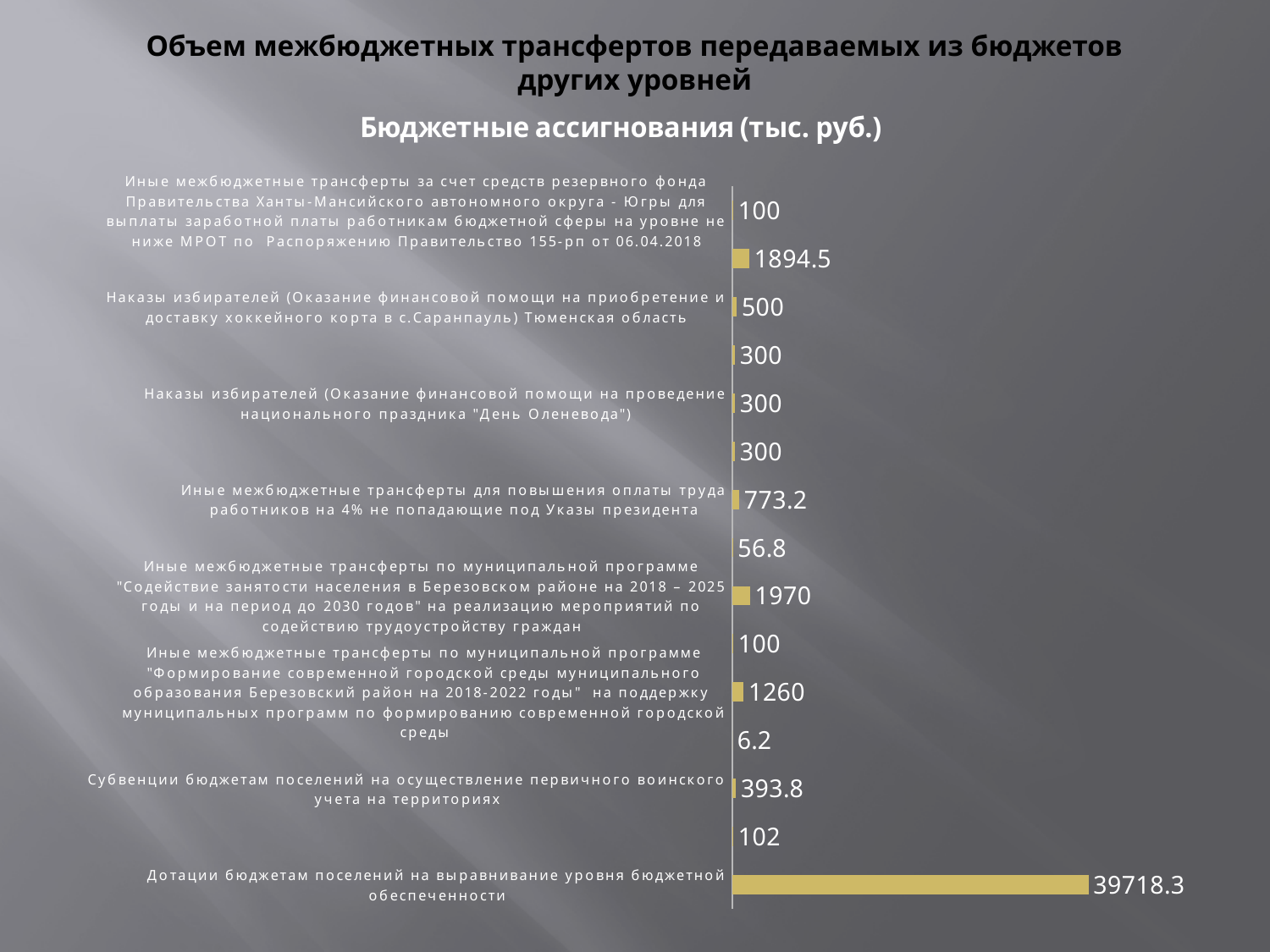
Which category has the highest value? Дотации бюджетам поселений на выравнивание уровня бюджетной обеспеченности What is the value for "Наказы избирателей (Оказание финансовой помощи на приобретение и доставку хоккейного корта в с.Саранпауль) Тюменская область"? 500 What type of chart is shown on the slide? Bar chart What is the value for the transfers under the municipal programme "Формирование современной городской среды муниципального образования Березовский район на 2018-2022 годы"? 1260 What is the value for "Дотации бюджетам поселений на выравнивание уровня бюджетной обеспеченности"? 39718.3 What is the value for "Субвенции бюджетам поселений на осуществление первичного воинского учета на территориях"? 393.8 What is the value for "Иные межбюджетные трансферты для повышения оплаты труда работников на 4% не попадающие под Указы президента"? 773.2 What is the value for the transfers under the municipal programme "Содействие занятости населения в Березовском районе на 2018 – 2025 годы..."? 1970 What is the smallest value shown on the chart? 6.2 What is the difference between the value for "Дотации бюджетам поселений на выравнивание уровня бюджетной обеспеченности" and the value for "Субвенции бюджетам поселений на осуществление первичного воинского учета на территориях"? 39324.5 Which is larger: the value for the programme "Содействие занятости населения в Березовском районе" or the value for the programme "Формирование современной городской среды"? Содействие занятости населения в Березовском районе How many data values are shown on the chart? 15